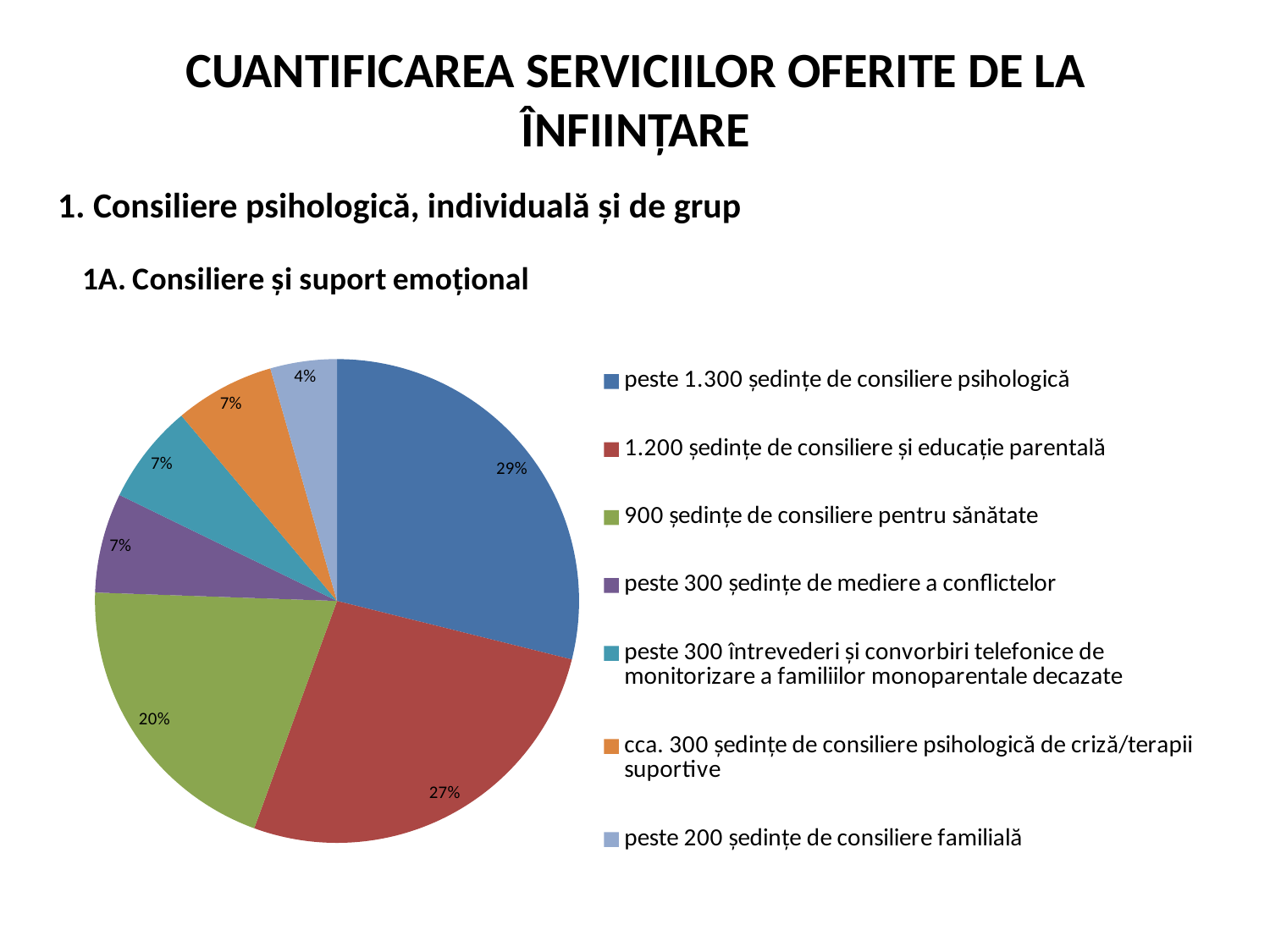
What type of chart is shown on the slide? pie chart What colour is the slice for "cca. 300 ședințe de consiliere psihologică de criză/terapii suportive"? orange Which category has the largest slice of the pie? peste 1.300 ședințe de consiliere psihologică What is the difference in percentage points between the slice for "peste 1.300 ședințe de consiliere psihologică" and the slice for "900 ședințe de consiliere pentru sănătate"? 9 How many slices does the pie chart have? 7 What share of the pie does the slice for "peste 1.300 ședințe de consiliere psihologică" represent? 29% What percentage is shown for "1.200 ședințe de consiliere și educație parentală"? 27% What percentage is shown for "peste 300 ședințe de mediere a conflictelor"? 7% Which category has the smallest slice of the pie? peste 200 ședințe de consiliere familială Which is larger: the slice for "1.200 ședințe de consiliere și educație parentală" or the slice for "900 ședințe de consiliere pentru sănătate"? 1.200 ședințe de consiliere și educație parentală What share of the pie does "peste 200 ședințe de consiliere familială" represent? 4% What percentage is shown for "900 ședințe de consiliere pentru sănătate"? 20%